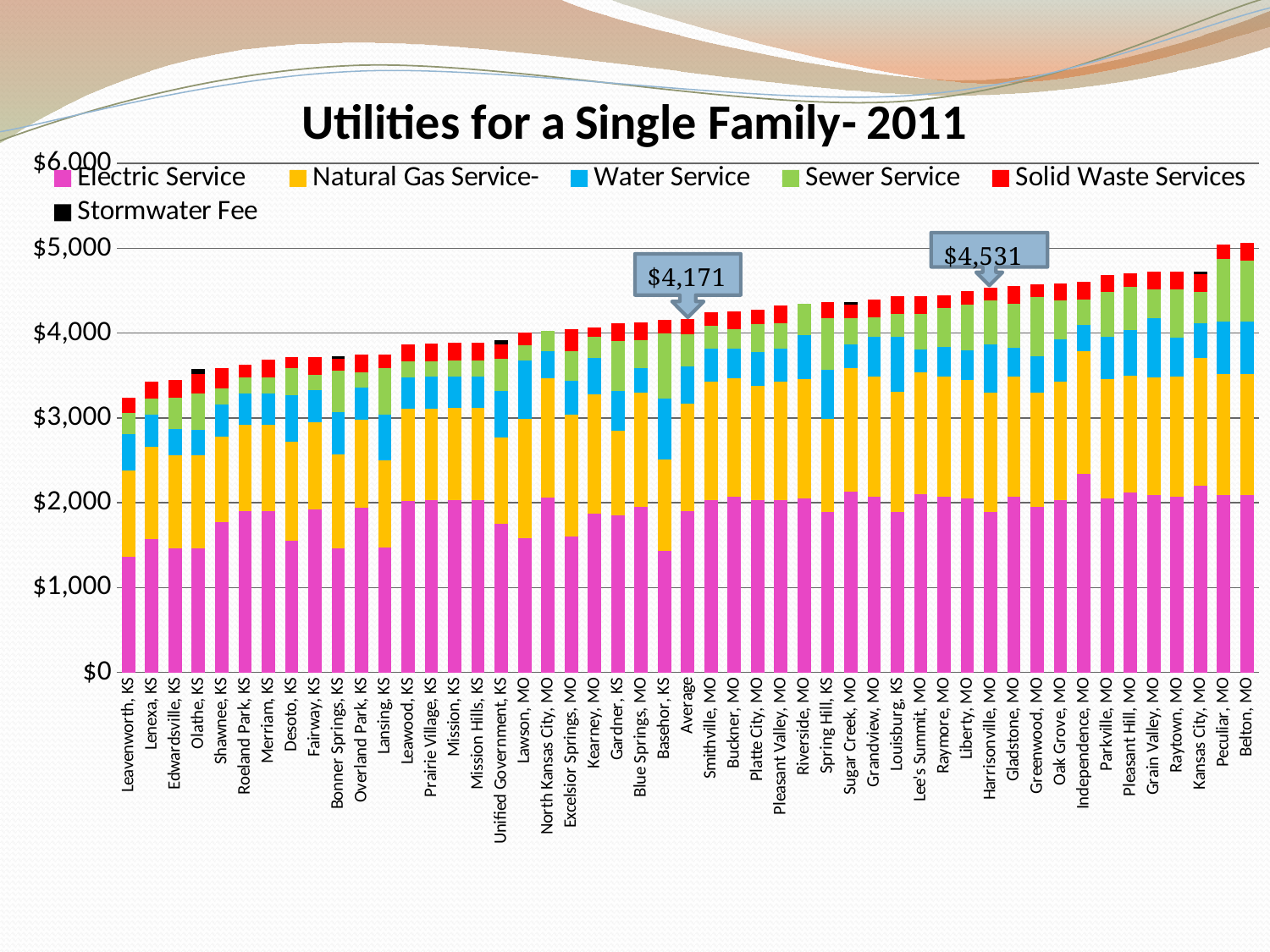
Is the total for Average greater or less than $4,000? greater Do the total bar heights generally rise or fall from left to right along the x axis? Rise Which colour represents Electric Service in the legend? Pink What is the title of the chart? Utilities for a Single Family- 2011 What value does the callout above the Average bar show? $4,171 What kind of chart is shown on the slide? Stacked bar chart How many series does the legend list? 6 Is the total for Leavenworth, KS greater or less than $3,500? less Is the total for Kansas City, MO greater or less than $4,500? greater Which has the larger total, Belton, MO or Leavenworth, KS? Belton, MO Which category has the lowest total utility cost? Leavenworth, KS